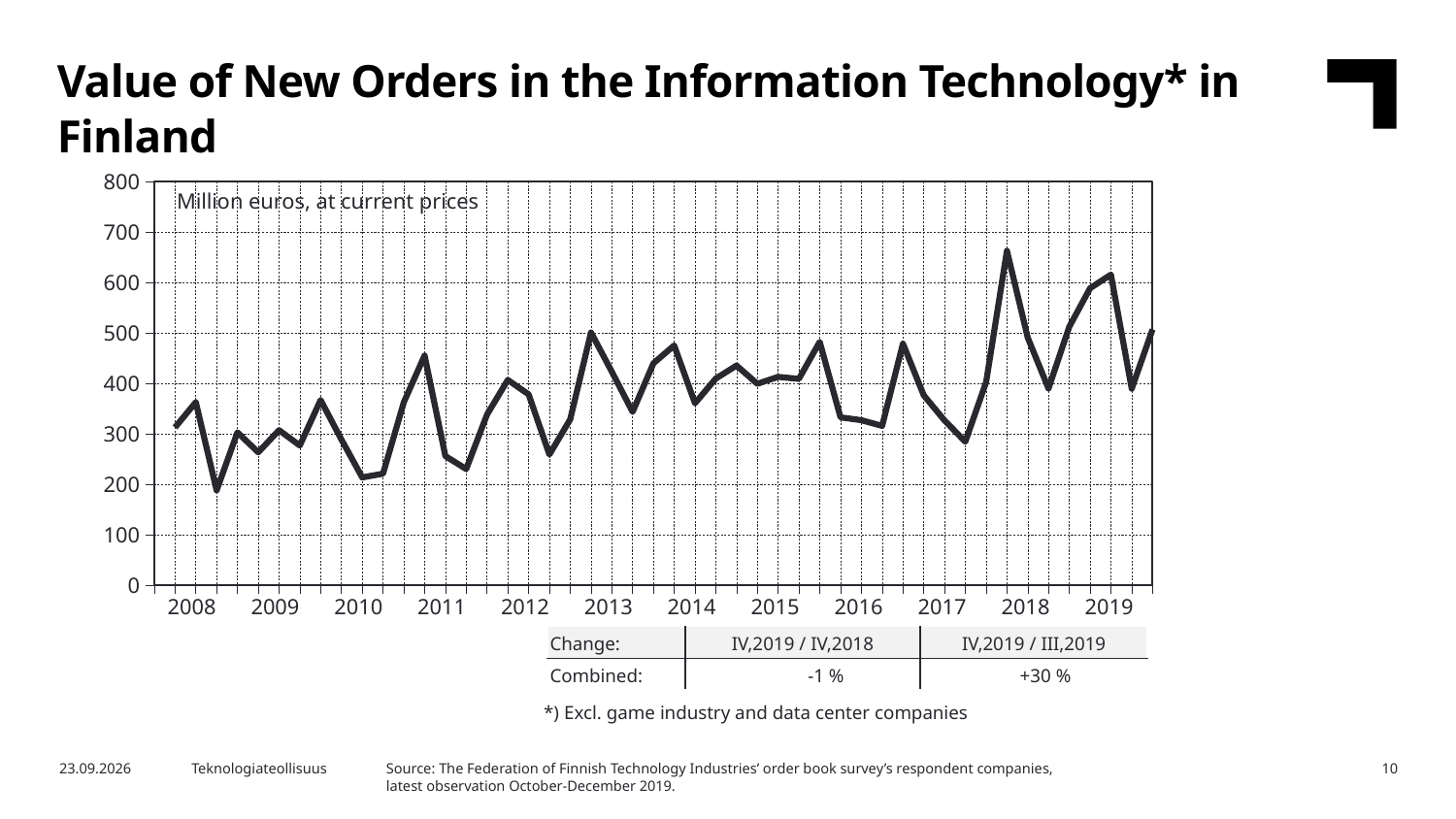
How many lines are plotted on the chart? 1 How many years are labelled on the x axis of the chart? 12 Is the lowest value of the line, reached in 2008, greater or less than 200? less According to the table below the chart, what is the combined change for IV,2019 / III,2019? +30 % What is the title of the chart? Value of New Orders in the Information Technology* in Finland In which year does the line reach its lowest value? 2008 Which is higher: the peak of the line in 2013 or the peak of the line in 2018? 2018 Is the highest value of the line, reached in 2018, greater or less than 600? greater In which year does the line reach its highest value? 2018 Is the last plotted value in 2019 greater or less than 400? greater What kind of chart is shown on the slide? line chart In what unit are the values on the chart expressed, according to the label inside the plot area? Million euros, at current prices